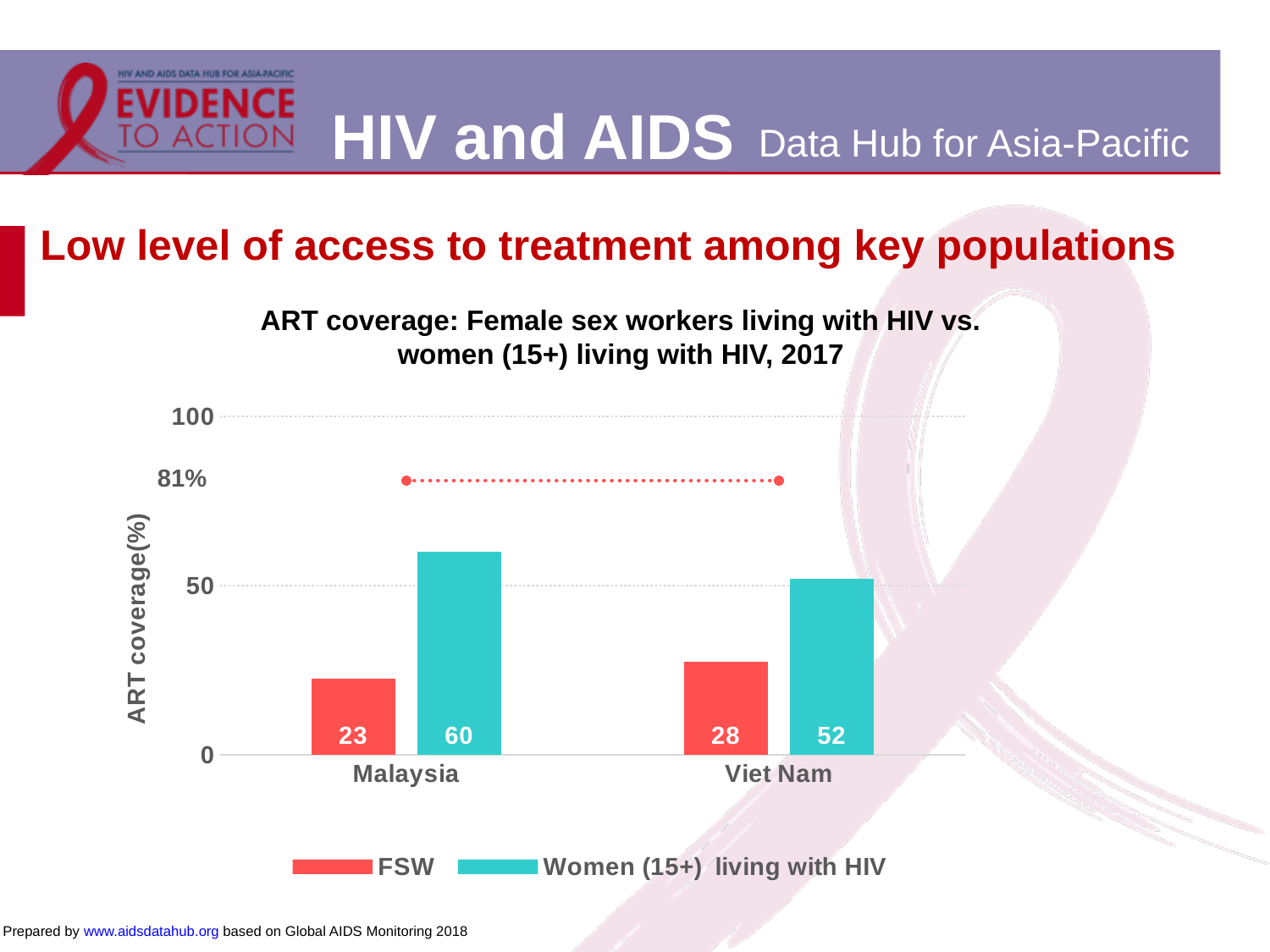
What kind of chart is shown on the slide? bar chart What is the ART coverage for FSW in Viet Nam? 28 How many countries are shown on the x axis? 2 What is the ART coverage for FSW in Malaysia? 23 Is the ART coverage for FSW in Viet Nam greater or less than 50? less What is the difference between ART coverage for Women (15+) living with HIV and FSW in Malaysia? 37 What is the difference between ART coverage for Women (15+) living with HIV and FSW in Viet Nam? 24 Which country has the lower ART coverage for FSW? Malaysia In Viet Nam, which group has higher ART coverage, FSW or Women (15+) living with HIV? Women (15+) living with HIV Which country has the higher ART coverage for Women (15+) living with HIV? Malaysia How many series does the legend list? 2 What is the ART coverage for Women (15+) living with HIV in Viet Nam? 52